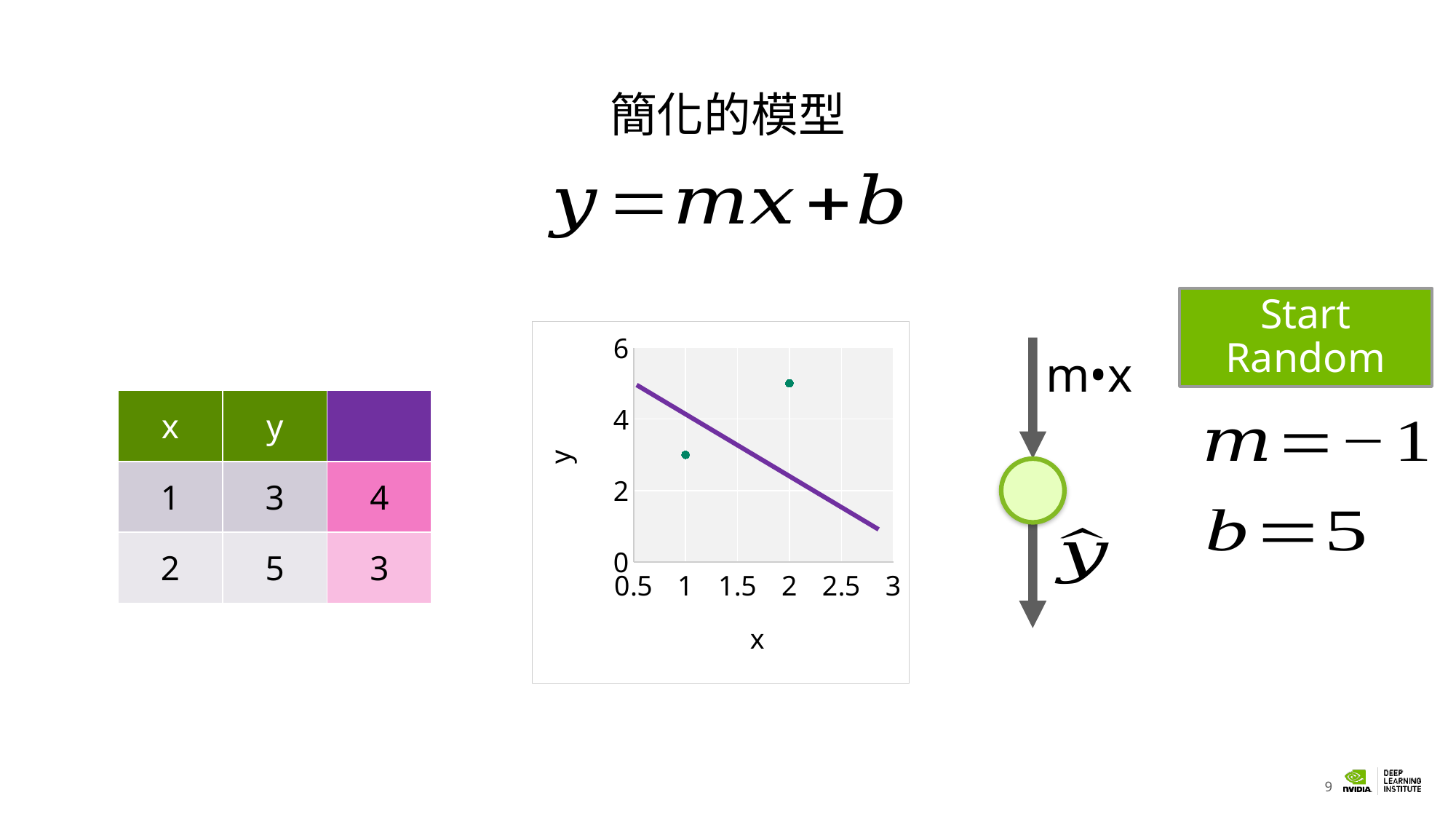
What kind of chart is shown on the slide? scatter chart Is the purple line's value at x = 2.5 greater or less than 2? less What is the highest tick value shown on the vertical axis of the chart? 6 Is the y value of the plotted point at x = 2 greater or less than 4? greater Does the purple line in the chart rise or fall as x increases? fall Is the y value of the plotted point at x = 1 greater or less than 2? greater Which plotted point has the higher y value, the one at x = 1 or the one at x = 2? the one at x = 2 What is the label of the horizontal axis of the chart? x How many data points are plotted in the chart? 2